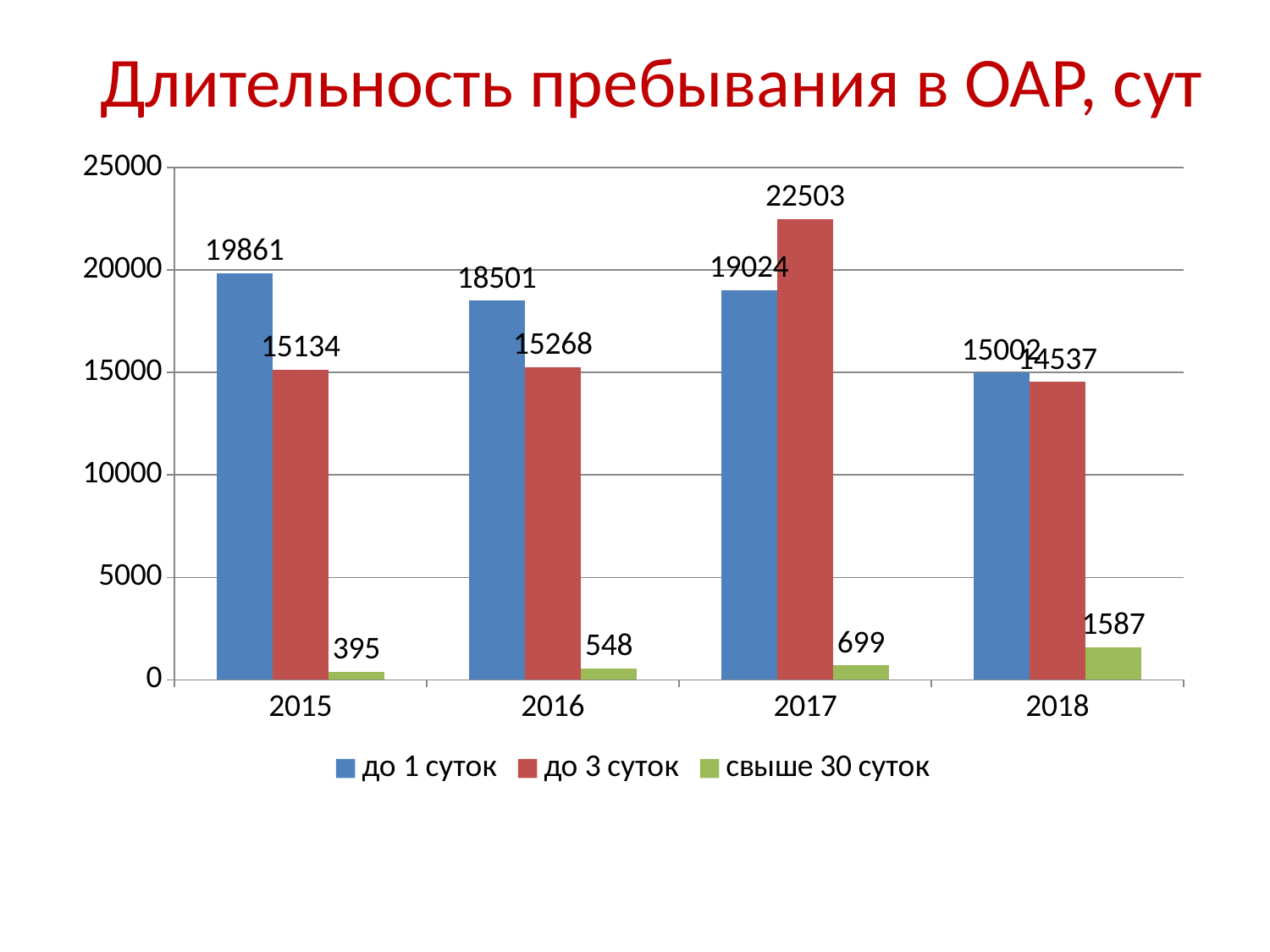
What is the value for "до 3 суток" in 2017? 22503 What is the value for "до 3 суток" in 2016? 15268 What kind of chart is shown on the slide? bar chart How many series does the legend list? 3 Does the value for "свыше 30 суток" rise or fall from 2015 to 2018? rise What is the value for "до 1 суток" in 2015? 19861 How many years are shown on the x axis? 4 What is the difference between the "до 1 суток" values for 2015 and 2018? 4859 Which is larger in 2017: "до 1 суток" or "до 3 суток"? до 3 суток In which year is the value for "до 3 суток" highest? 2017 In which year is the value for "свыше 30 суток" lowest? 2015 What is the value for "свыше 30 суток" in 2018? 1587